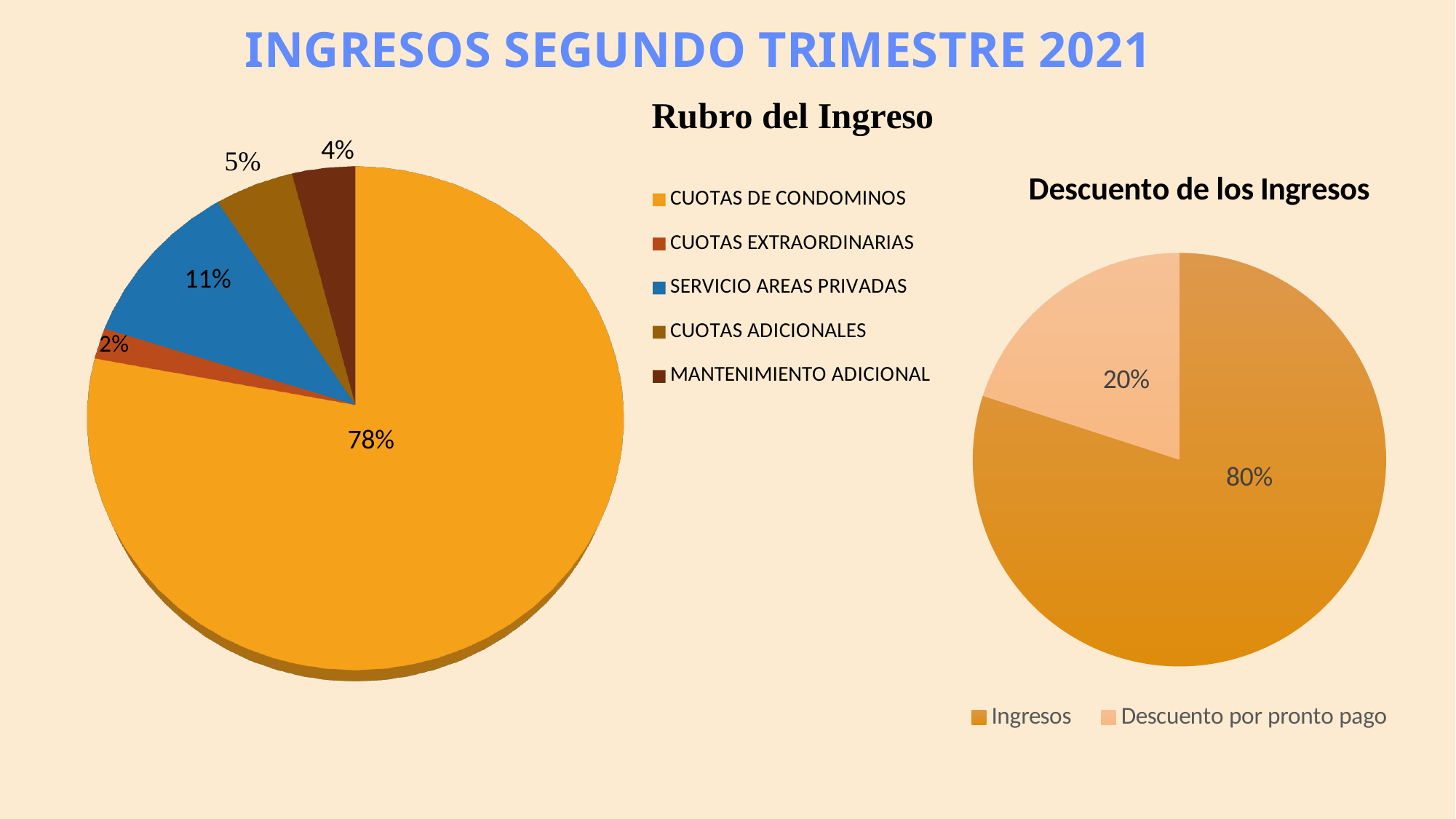
In the 'Rubro del Ingreso' chart, what is the difference between the shares of SERVICIO AREAS PRIVADAS and CUOTAS ADICIONALES? 6% In the 'Rubro del Ingreso' chart, what share does CUOTAS DE CONDOMINOS have? 78% What kind of chart is the 'Descuento de los Ingresos' chart? Pie chart In the 'Descuento de los Ingresos' chart, what share does Ingresos have? 80% In the 'Rubro del Ingreso' chart, which category has the smallest share? CUOTAS EXTRAORDINARIAS In the 'Rubro del Ingreso' chart, what share does MANTENIMIENTO ADICIONAL have? 4% In the 'Rubro del Ingreso' chart, which category has the largest share? CUOTAS DE CONDOMINOS In the 'Rubro del Ingreso' chart, how many categories does the legend list? 5 In the 'Rubro del Ingreso' chart, which colour represents SERVICIO AREAS PRIVADAS? Blue